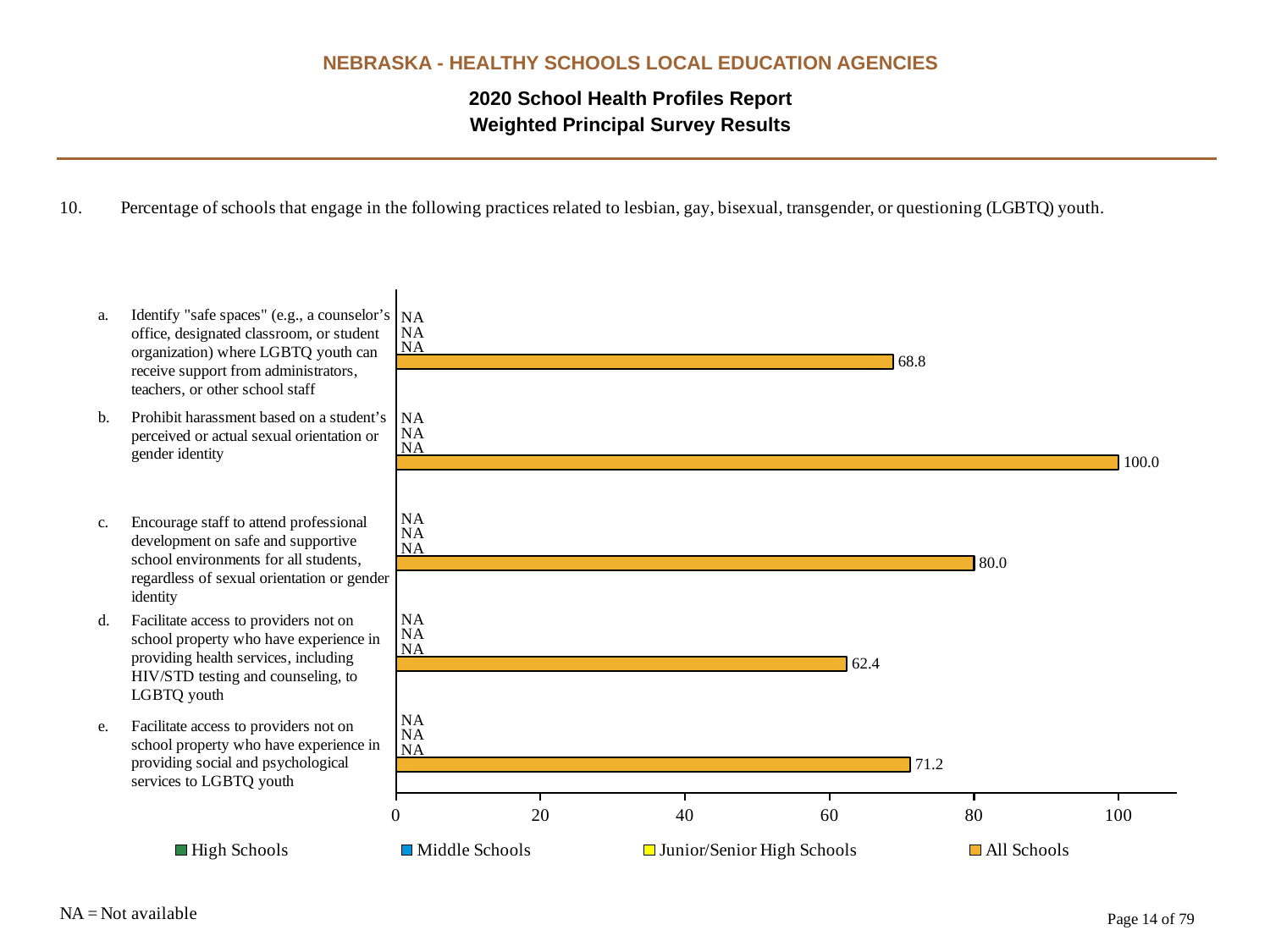
How many series does the legend list? 4 What type of chart is shown on the slide? bar chart What is the All Schools value for practice e, facilitating access to providers of social and psychological services to LGBTQ youth? 71.2 What is the difference between the All Schools values for practice b and practice d? 37.6 Which is larger, the All Schools value for practice a or practice e? practice e (71.2) What is the All Schools value for practice b, prohibiting harassment based on sexual orientation or gender identity? 100.0 What is the All Schools value for practice d, facilitating access to providers of health services including HIV/STD testing to LGBTQ youth? 62.4 What is the All Schools value for practice c, encouraging staff to attend professional development on safe and supportive school environments? 80.0 Which practice has the highest All Schools value? b. Prohibit harassment based on a student's perceived or actual sexual orientation or gender identity What is the All Schools value for practice a, identifying "safe spaces" for LGBTQ youth? 68.8 Which practice has the lowest All Schools value? d. Facilitate access to providers not on school property who have experience in providing health services, including HIV/STD testing and counseling, to LGBTQ youth What value is shown for High Schools, Middle Schools, and Junior/Senior High Schools for every practice? NA